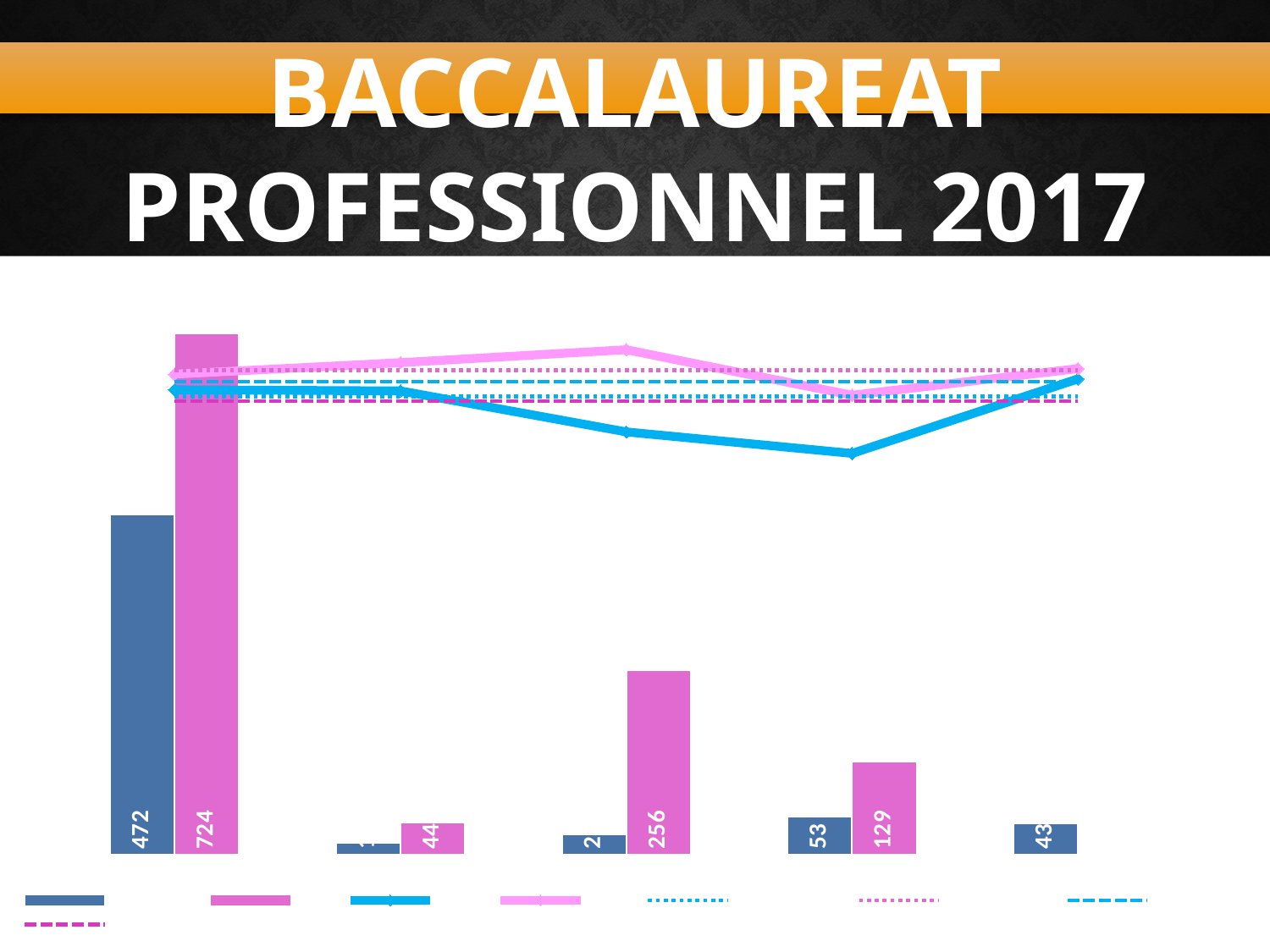
Which group has the tallest pink bar? The first (leftmost) group What is the value of the blue bar in the fourth group? 53 How many entries does the legend list? 8 In the third group, which bar is larger, the blue bar or the pink bar? The pink bar What is the value of the blue bar in the first (leftmost) group? 472 How many groups of bars are plotted along the x axis? 5 What is the difference between the pink bar (129) and the blue bar (53) in the fourth group? 76 What is the difference between the pink bar (724) and the blue bar (472) in the first group? 252 What is the value of the pink bar in the first (leftmost) group? 724 What is the value of the pink bar in the fourth group? 129 What kind of chart is shown on the slide? A combined bar and line chart What is the title of the slide containing the chart? BACCALAUREAT PROFESSIONNEL 2017